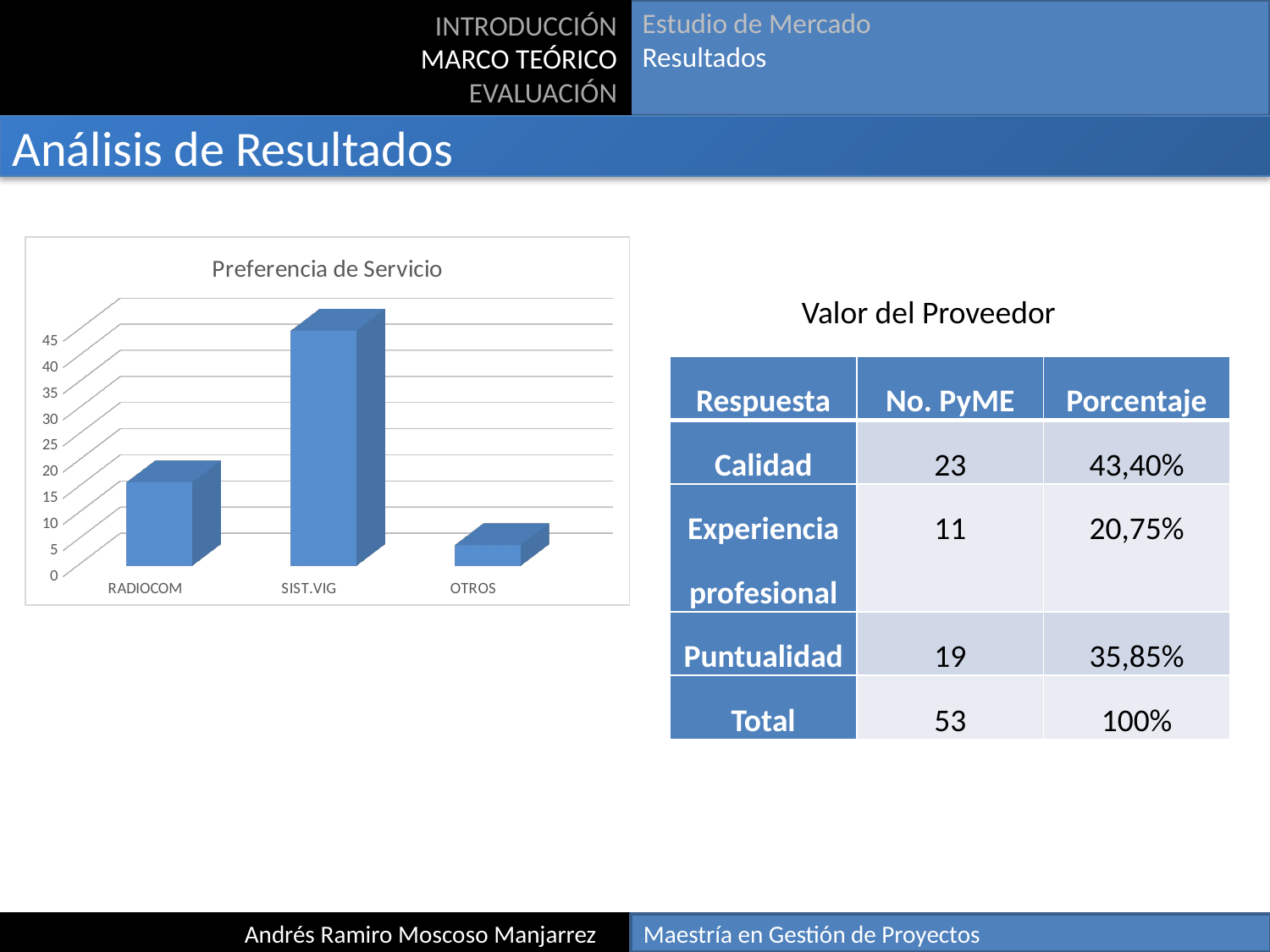
Is the value for OTROS greater or less than 10? less Is the value for SIST.VIG greater or less than 40? greater Which is larger, the value for SIST.VIG or the value for RADIOCOM? SIST.VIG Which category has the highest value in the chart? SIST.VIG What is the highest tick value shown on the vertical axis of the chart? 45 Is the value for RADIOCOM greater or less than 10? greater Which category has the lowest value in the chart? OTROS What is the title of the chart? Preferencia de Servicio What type of chart is shown on the slide? bar chart Which is larger, the value for RADIOCOM or the value for OTROS? RADIOCOM How many categories are shown on the x axis of the chart? 3